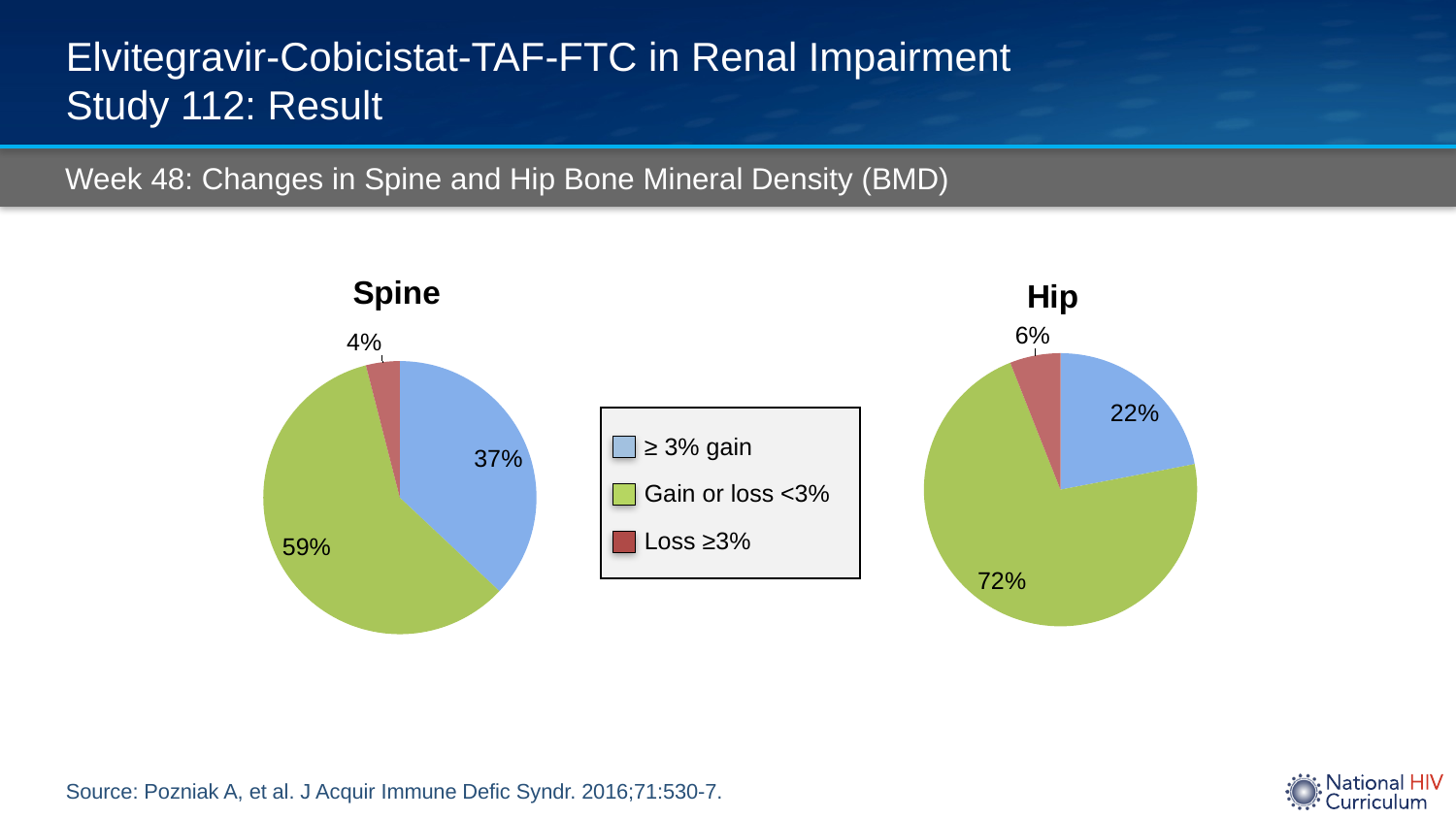
How many categories does the legend list? 3 What type of chart is used to show the Hip BMD changes? Pie chart In the Hip pie chart, what percentage of participants had a gain or loss <3%? 72% In the Hip pie chart, what percentage of participants had a loss ≥3% in BMD? 6% Which is larger: the Gain or loss <3% share in the Spine chart or in the Hip chart? Hip In the Hip pie chart, which category has the smallest share? Loss ≥3% In the Spine pie chart, what percentage of participants had a ≥ 3% gain in BMD? 37% How many slices does the Spine pie chart have? 3 In the Spine pie chart, what is the difference between the Gain or loss <3% share and the ≥ 3% gain share? 22% What is the difference between the ≥ 3% gain share in the Spine chart and the ≥ 3% gain share in the Hip chart? 15% Which colour represents Loss ≥3% in the legend? Red In the Spine pie chart, which category has the largest share? Gain or loss <3%